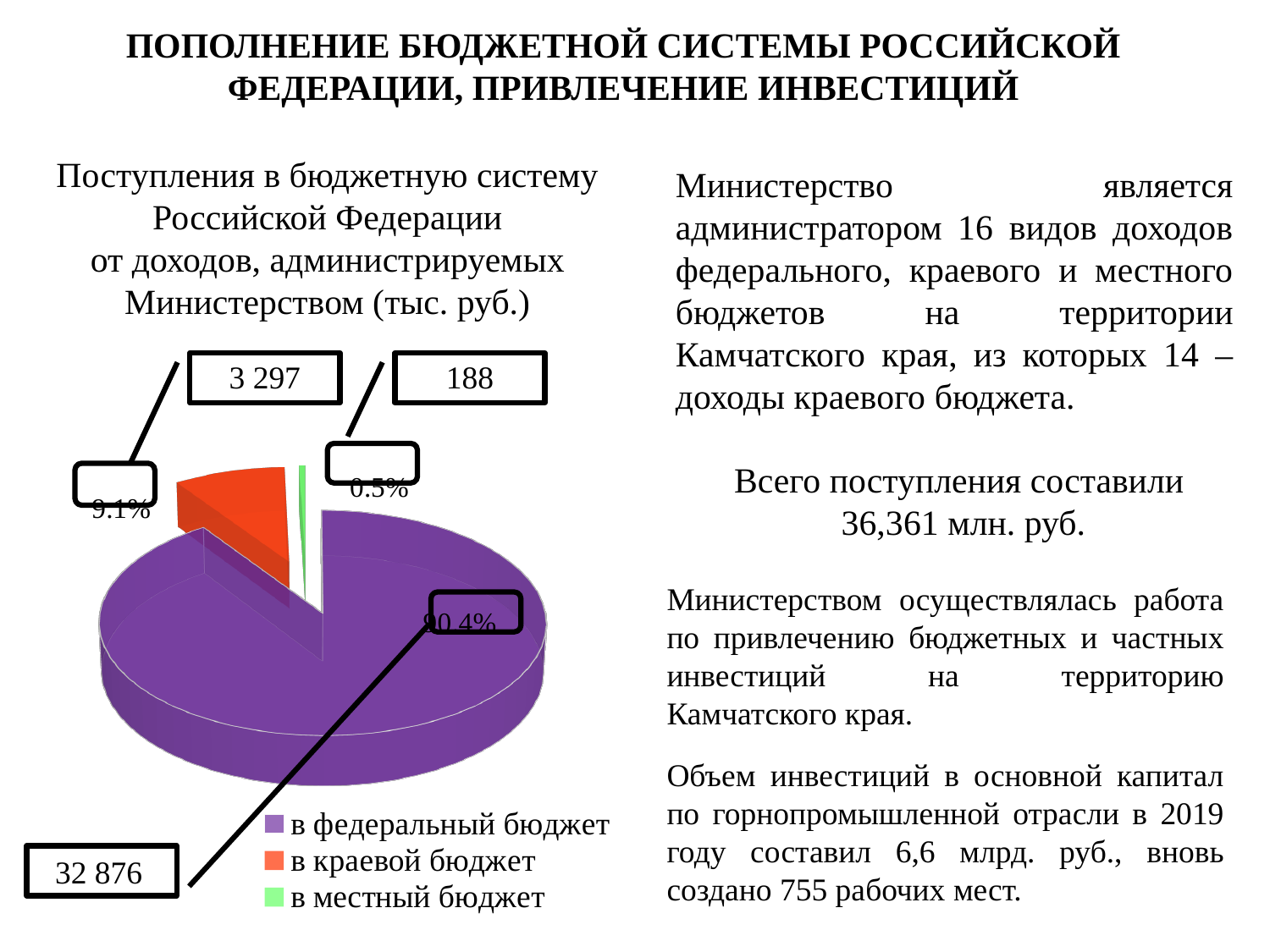
What share of the pie does "в краевой бюджет" represent? 9.1% How many slices does the pie chart have? 3 How many entries does the legend of the pie chart list? 3 What is the value for "в местный бюджет" in the pie chart? 188 What share of the pie does "в федеральный бюджет" represent? 90.4% Which category has the smallest slice in the pie chart? в местный бюджет What is the value for "в краевой бюджет" in the pie chart? 3 297 What is the difference between the values for "в краевой бюджет" and "в местный бюджет"? 3 109 What kind of chart is shown on the slide? pie chart Which colour represents "в краевой бюджет" in the pie chart? orange Which category has the largest slice in the pie chart? в федеральный бюджет What is the value for "в федеральный бюджет" in the pie chart? 32 876